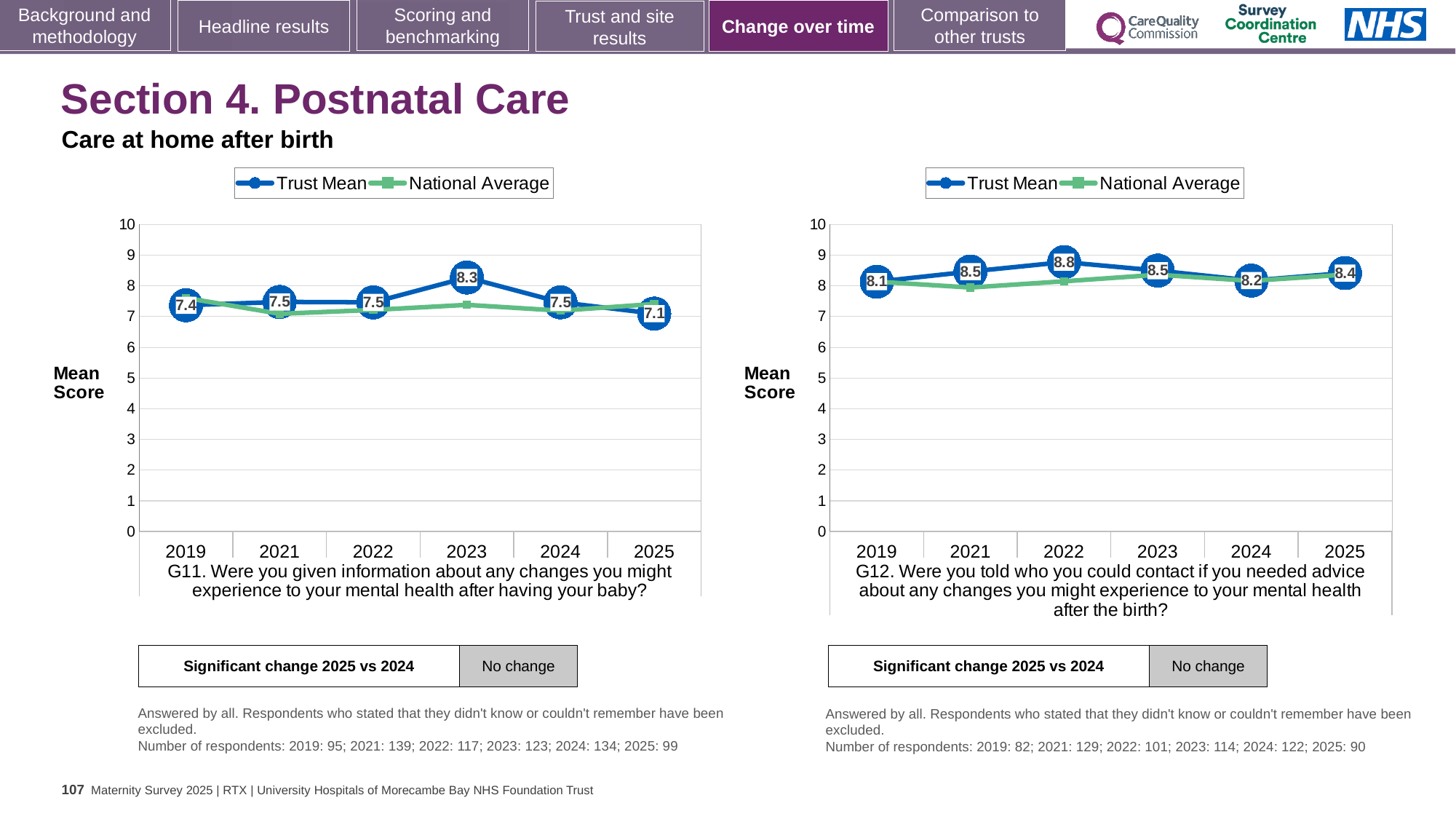
In the G12 chart, what is the Trust Mean for 2022? 8.8 In the G12 chart, which year has the highest Trust Mean? 2022 In the G12 chart, what is the Trust Mean for 2019? 8.1 In the G12 chart, is the Trust Mean for 2024 greater or less than the Trust Mean for 2025? less In the G11 chart, what is the Trust Mean for 2023? 8.3 In the G11 chart, what is the difference between the Trust Mean in 2023 and in 2025? 1.2 In the G12 chart, is the Trust Mean for 2022 greater or less than 8? greater How many series does the legend of the G12 chart list? 2 How many years are plotted on the x axis of the G11 chart? 6 In the G11 chart, what is the Trust Mean for 2025? 7.1 In the G11 chart, which year has the lowest Trust Mean? 2025 In the G11 chart, which year has the highest Trust Mean? 2023